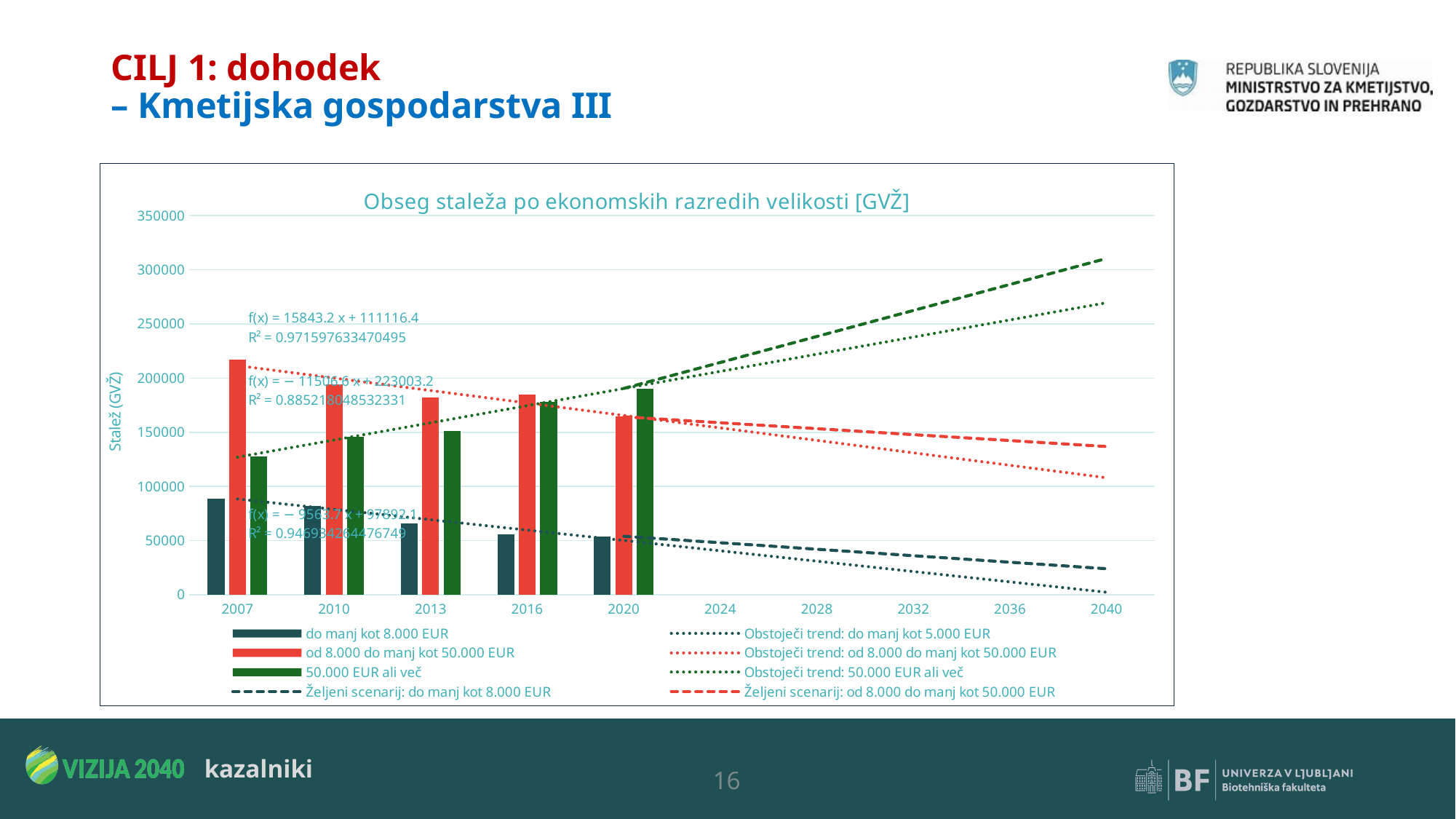
Is the 2020 value for '50.000 EUR ali več' greater or less than 150000? greater In 2007, which is larger: the bar for 'od 8.000 do manj kot 50.000 EUR' or the bar for '50.000 EUR ali več'? od 8.000 do manj kot 50.000 EUR In which year is the bar for 'od 8.000 do manj kot 50.000 EUR' the highest? 2007 How many years have bars plotted in the chart? 5 Do the bars for 'do manj kot 8.000 EUR' rise or fall from 2007 to 2020? fall In which year is the bar for 'do manj kot 8.000 EUR' the highest? 2007 Is the 2007 value for 'od 8.000 do manj kot 50.000 EUR' greater or less than 200000? greater Is the 2007 value for 'do manj kot 8.000 EUR' greater or less than 100000? less How many entries does the chart legend list? 8 What kind of chart is used to show the stock by economic size class? bar chart What is the title of the chart? Obseg staleža po ekonomskih razredih velikosti [GVŽ] In which year is the bar for '50.000 EUR ali več' the highest? 2020